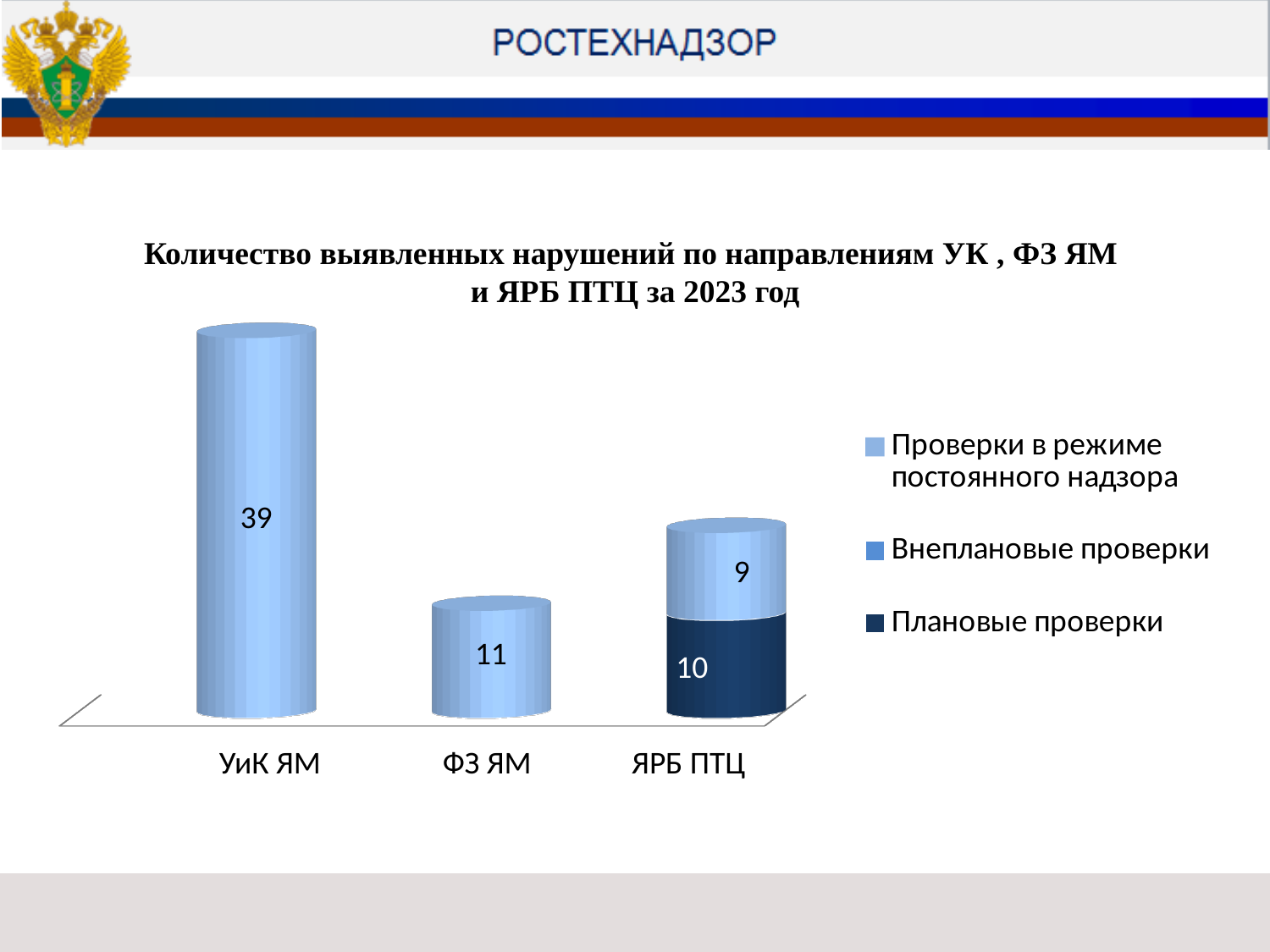
What type of chart is shown on the slide? Stacked bar chart What is the value of the 'Плановые проверки' (dark blue) segment for ЯРБ ПТЦ? 10 What is the value of the 'Проверки в режиме постоянного надзора' bar for УиК ЯМ? 39 How many series does the legend list? 3 How many categories are shown on the x axis? 3 Which category has the lowest total number of violations? ФЗ ЯМ Which is larger: the value for ФЗ ЯМ or the 'Плановые проверки' segment for ЯРБ ПТЦ? ФЗ ЯМ What is the value of the upper (light blue) segment of the ЯРБ ПТЦ bar? 9 What is the difference between the value for УиК ЯМ and the value for ФЗ ЯМ? 28 What value is shown on the bar for ФЗ ЯМ? 11 Which category has the highest total number of violations? УиК ЯМ What is the total of the stacked bar for ЯРБ ПТЦ? 19